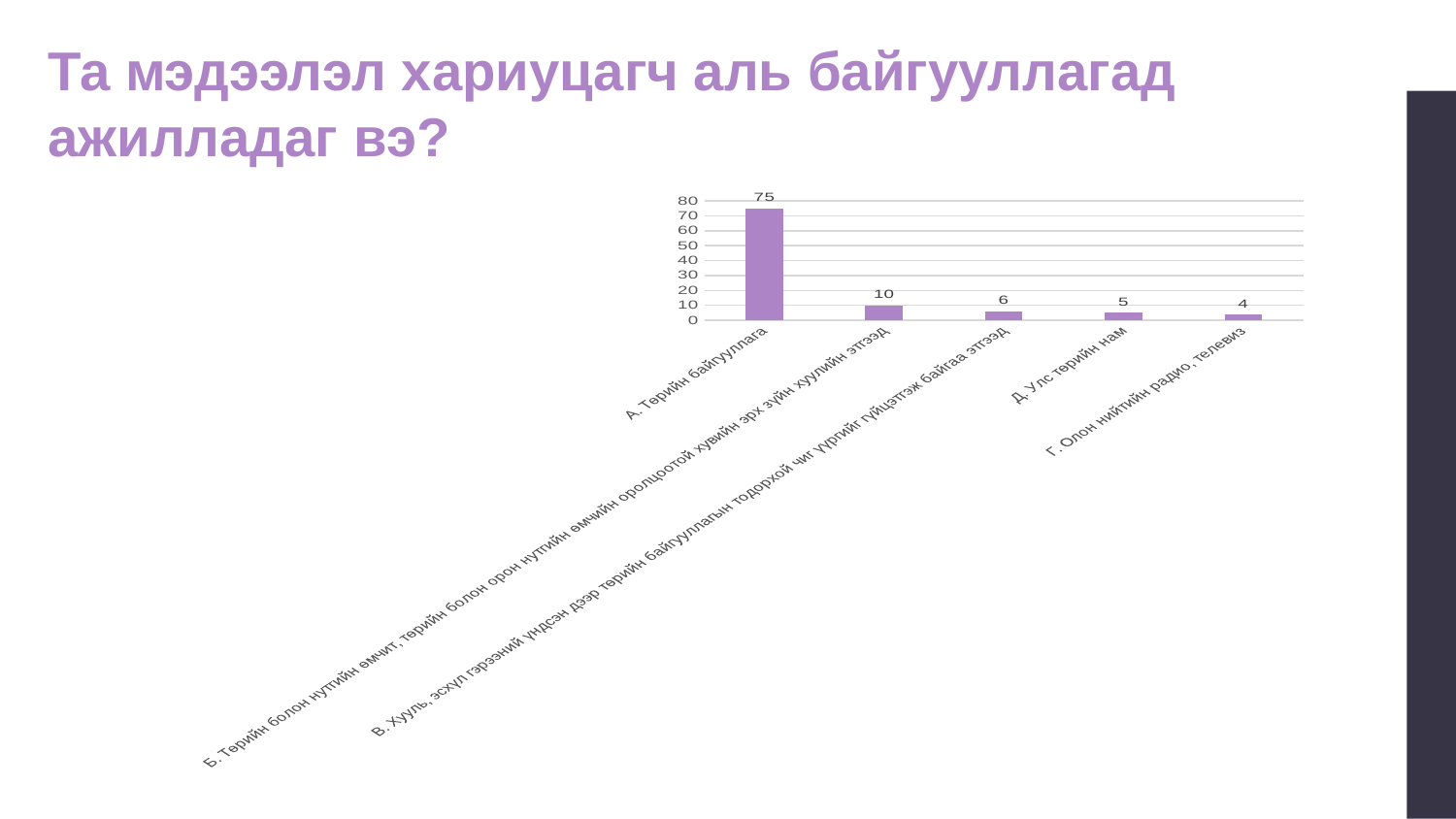
What is the value for "Г. Олон нийтийн радио, телевиз"? 4 What is the value for the category labelled "Б. Төрийн болон нутгийн өмчит..."? 10 Which category has the highest value? А. Төрийн байгууллага What is the difference between the values for "А. Төрийн байгууллага" and "Д. Улс төрийн нам"? 70 What is the value for "Д. Улс төрийн нам"? 5 Is the value for "А. Төрийн байгууллага" greater or less than 50? greater Which is larger: the value for "Д. Улс төрийн нам" or for "Г. Олон нийтийн радио, телевиз"? Д. Улс төрийн нам Which category has the lowest value? Г. Олон нийтийн радио, телевиз What kind of chart is shown on the slide? bar chart What is the title of the slide containing the chart? Та мэдээлэл хариуцагч аль байгууллагад ажилладаг вэ? What is the value for "А. Төрийн байгууллага"? 75 How many categories are shown in the chart? 5